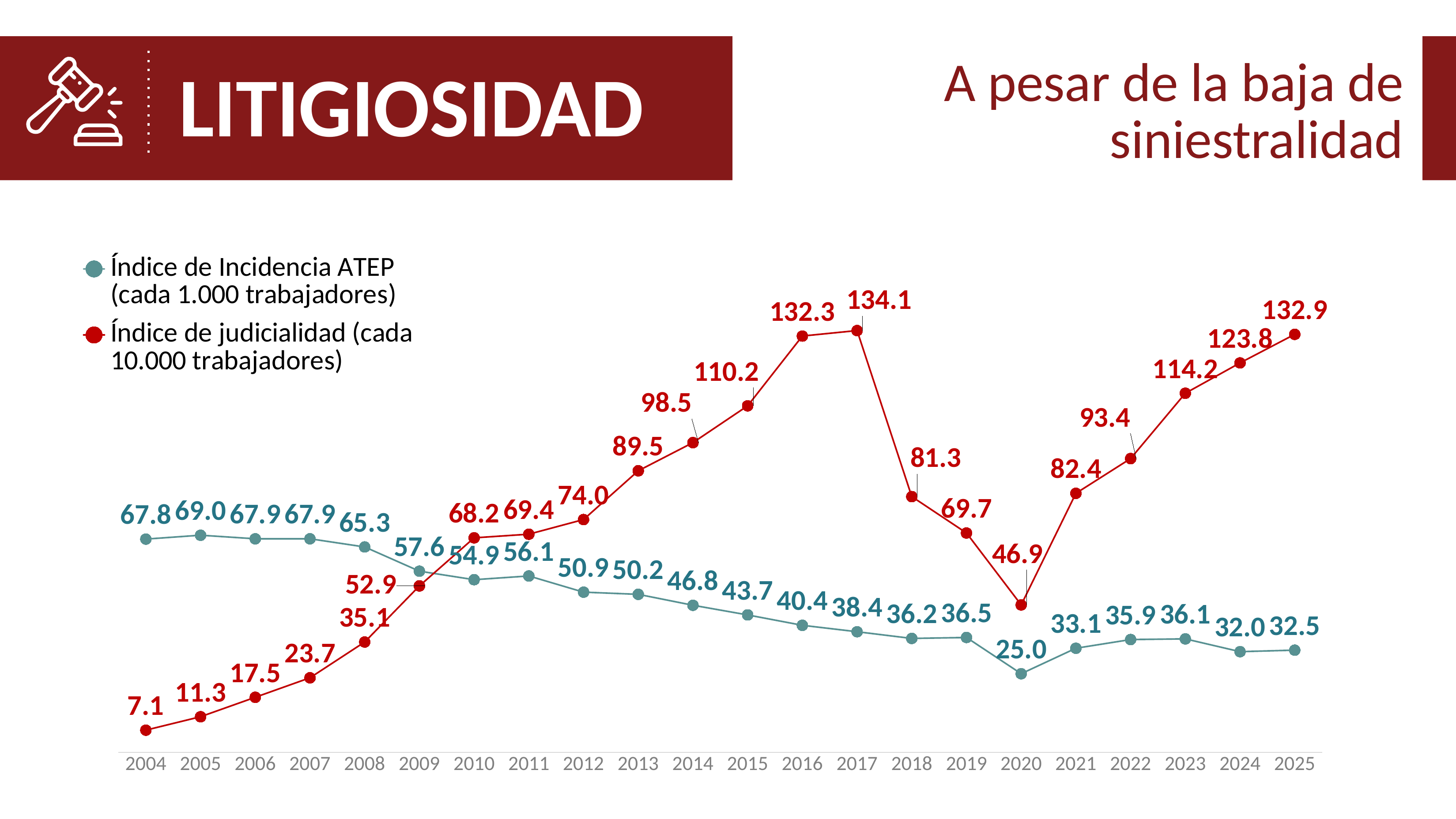
What is the value of the Índice de Incidencia ATEP in 2020? 25.0 By how much did the Índice de judicialidad increase from 2004 to 2025? 125.8 In which year does the Índice de judicialidad reach its highest value? 2017 What is the value of the Índice de judicialidad in 2017? 134.1 What type of chart is shown on the slide? Line chart What is the difference between the Índice de Incidencia ATEP in 2004 and in 2025? 35.3 What is the value of the Índice de judicialidad in 2020? 46.9 In which year is the Índice de Incidencia ATEP at its lowest? 2020 How many years are shown on the x axis of the chart? 22 How many series does the legend list? 2 In 2009, which series has the higher value: Índice de Incidencia ATEP or Índice de judicialidad? Índice de Incidencia ATEP Does the Índice de Incidencia ATEP generally rise or fall from 2004 to 2020? Fall